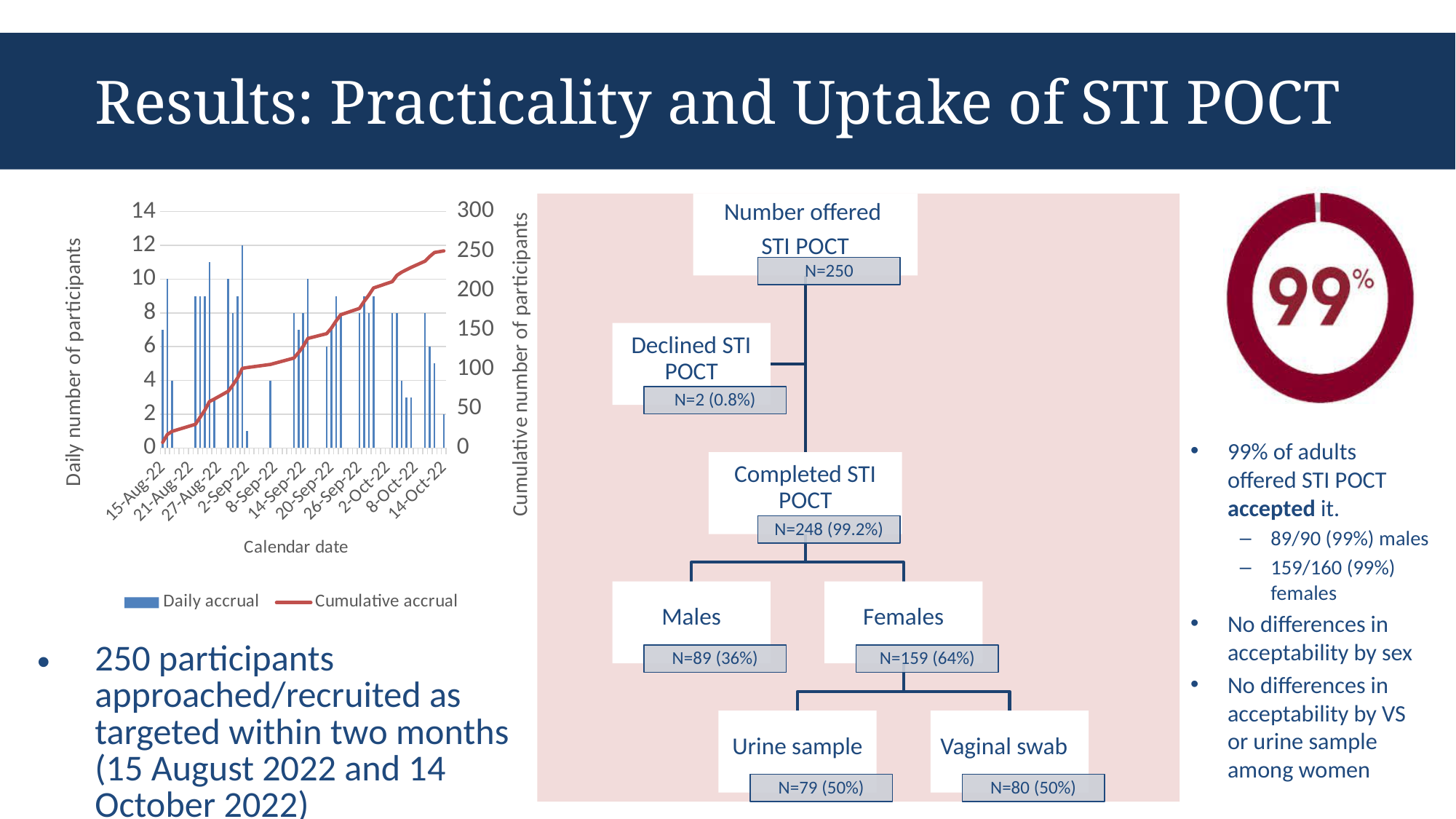
In the accrual chart, is the tallest daily accrual bar greater or less than 10 participants? greater What is the maximum value shown on the right-hand (cumulative) axis of the accrual chart? 300 In the accrual chart, is the cumulative accrual at 15-Aug-22 greater or less than 50? less In the accrual chart, which series is drawn as a red line? Cumulative accrual In the accrual chart, is the cumulative accrual at 14-Oct-22 greater or less than 200? greater In the accrual chart, does the cumulative accrual line rise or fall from 15-Aug-22 to 14-Oct-22? Rises How many series does the legend of the accrual chart list? 2 How many date labels are shown on the x axis of the accrual chart? 11 What is the title of the x axis of the accrual chart? Calendar date What type of chart is the accrual chart on the left of the slide? A combined bar and line chart What percentage is displayed in the donut graphic on the right of the slide? 99%